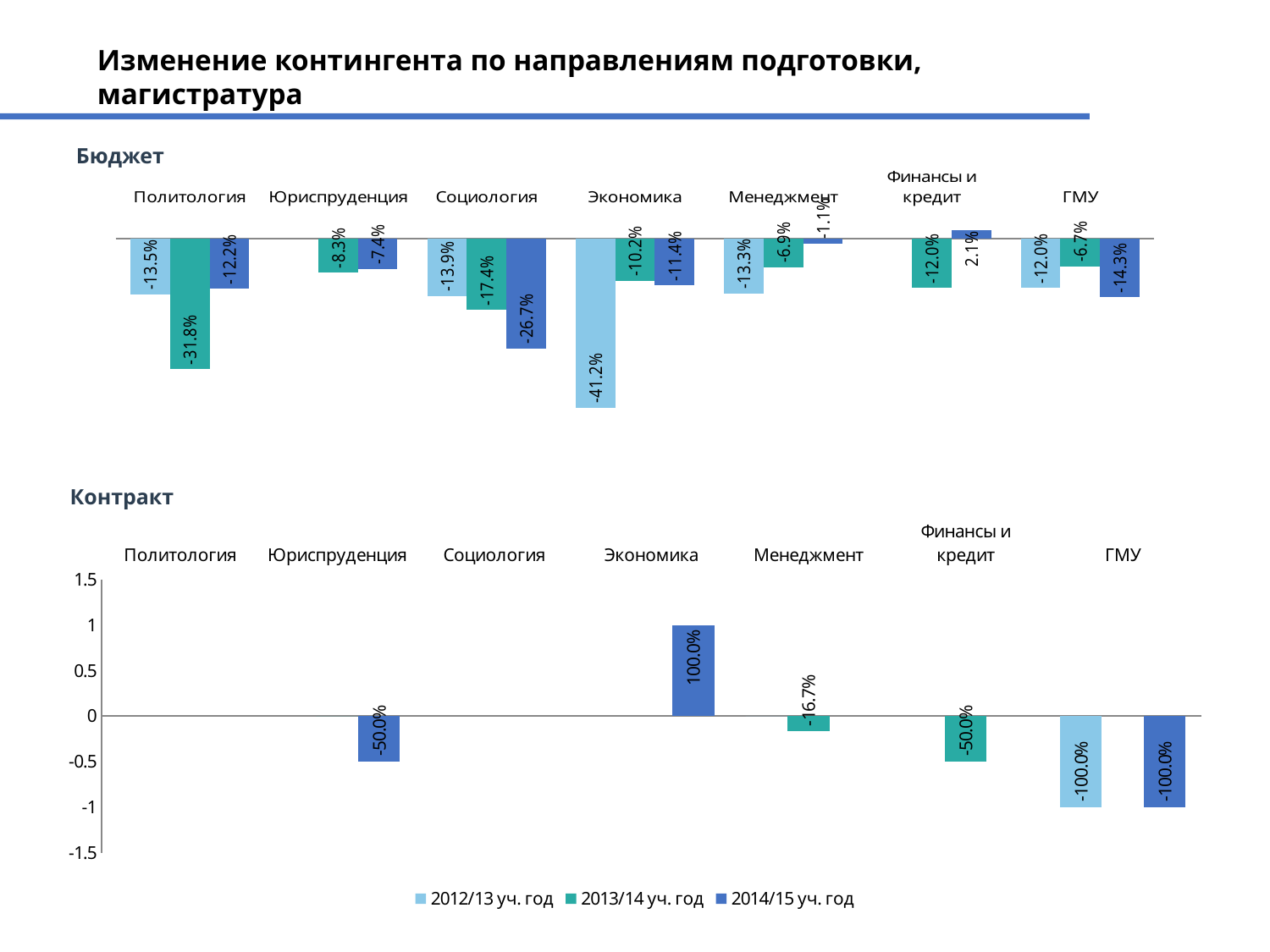
What kind of chart is the Контракт chart? Bar chart In the Контракт chart, what is the value for Менеджмент in 2013/14 уч. год? -16.7% In the Бюджет chart, what is the value for Финансы и кредит in 2014/15 уч. год? 2.1% In the Бюджет chart, which category has the lowest value in 2012/13 уч. год? Экономика In the Бюджет chart, what is the value for Политология in 2013/14 уч. год? -31.8% In the Контракт chart, what is the value for ГМУ in 2012/13 уч. год? -100.0% In the Бюджет chart, which is larger for Менеджмент: the 2013/14 уч. год value or the 2014/15 уч. год value? 2014/15 уч. год In the Контракт chart, which category has the highest value? Экономика In the Контракт chart, what is the value for Экономика in 2014/15 уч. год? 100.0% In the Бюджет chart, what is the difference between the 2014/15 уч. год values for Социология and ГМУ? 12.4 percentage points How many series does the legend list? 3 In the Бюджет chart, what is the value for Экономика in 2012/13 уч. год? -41.2%